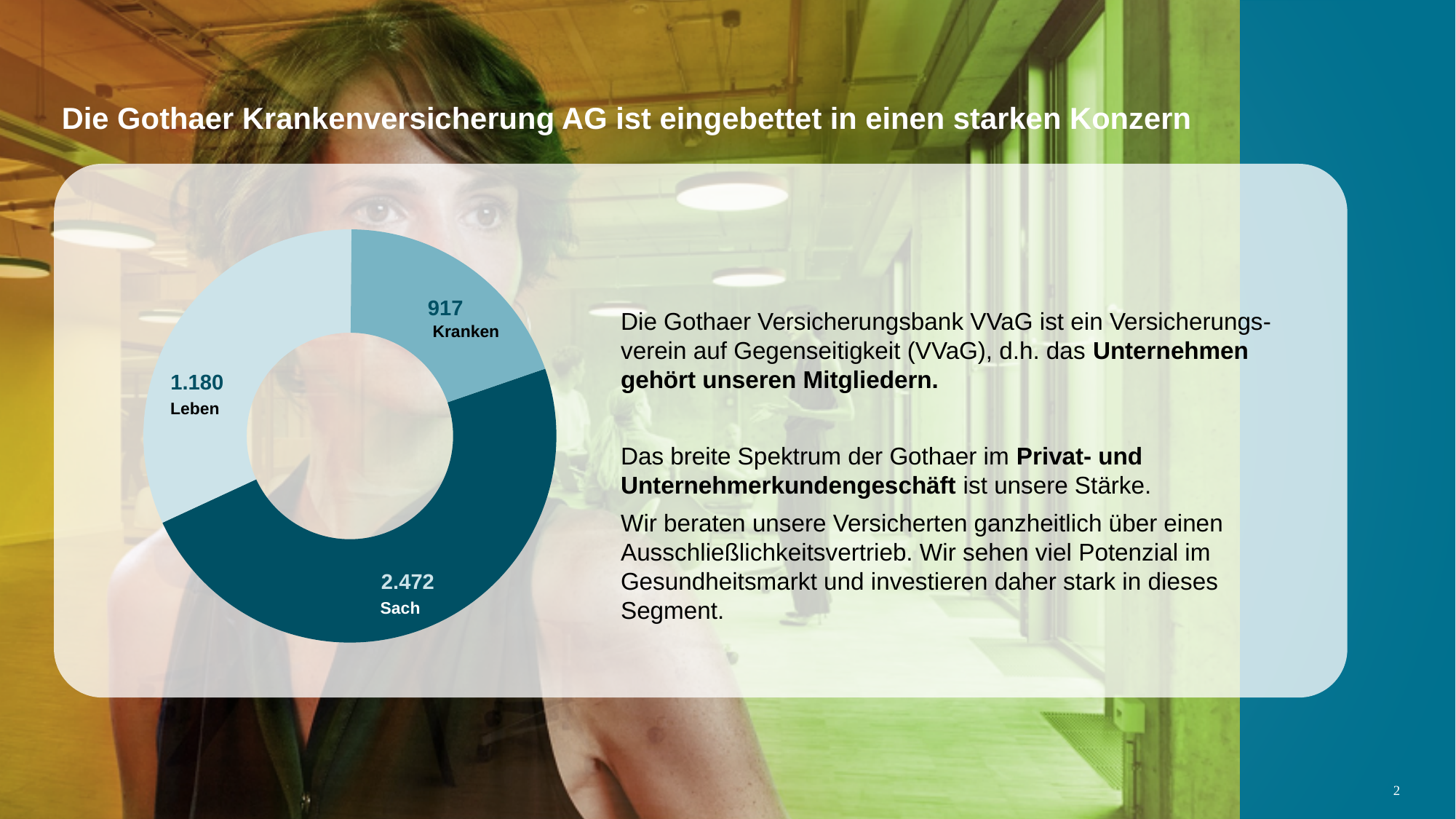
Which segment of the donut chart has the lowest value? Kranken What value is shown for the Kranken segment of the donut chart? 917 What is the difference between the Leben and Kranken values in the donut chart? 263 Which segment of the donut chart has the highest value? Sach What value is shown for the Sach segment of the donut chart? 2.472 What kind of chart is shown on the slide? Donut (pie) chart What is the difference between the Sach and Leben values in the donut chart? 1.292 Which segment of the donut chart is drawn in the darkest colour? Sach What is the total of all three segments in the donut chart? 4.569 How many segments does the donut chart have? 3 Which is larger in the donut chart, Leben or Kranken? Leben What value is shown for the Leben segment of the donut chart? 1.180